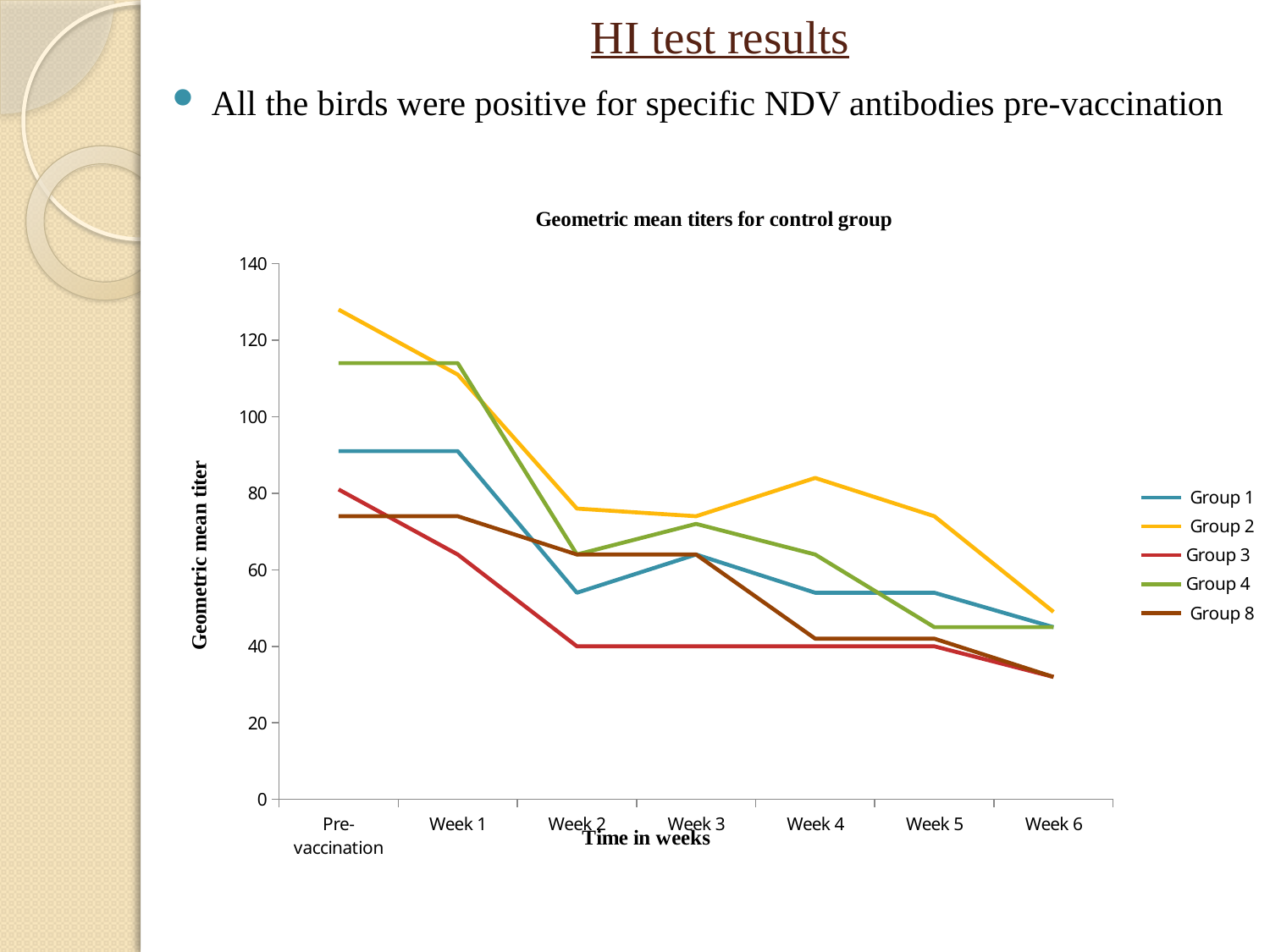
What is the label of the vertical axis? Geometric mean titer Is the value for Group 3 at Week 6 greater or less than 40? less What is the title of the chart? Geometric mean titers for control group Which group has the highest geometric mean titer at pre-vaccination? Group 2 Which group has the highest geometric mean titer at Week 5? Group 2 Is the value for Group 8 at Week 4 greater or less than 60? less What kind of chart is shown on the slide? line chart Does the geometric mean titer for Group 3 generally rise or fall from pre-vaccination to Week 6? fall How many series does the legend list? 5 Is the value for Group 2 at pre-vaccination greater or less than 120? greater At Week 2, which is larger: the value for Group 1 or the value for Group 3? Group 1 How many time points are plotted along the x axis? 7